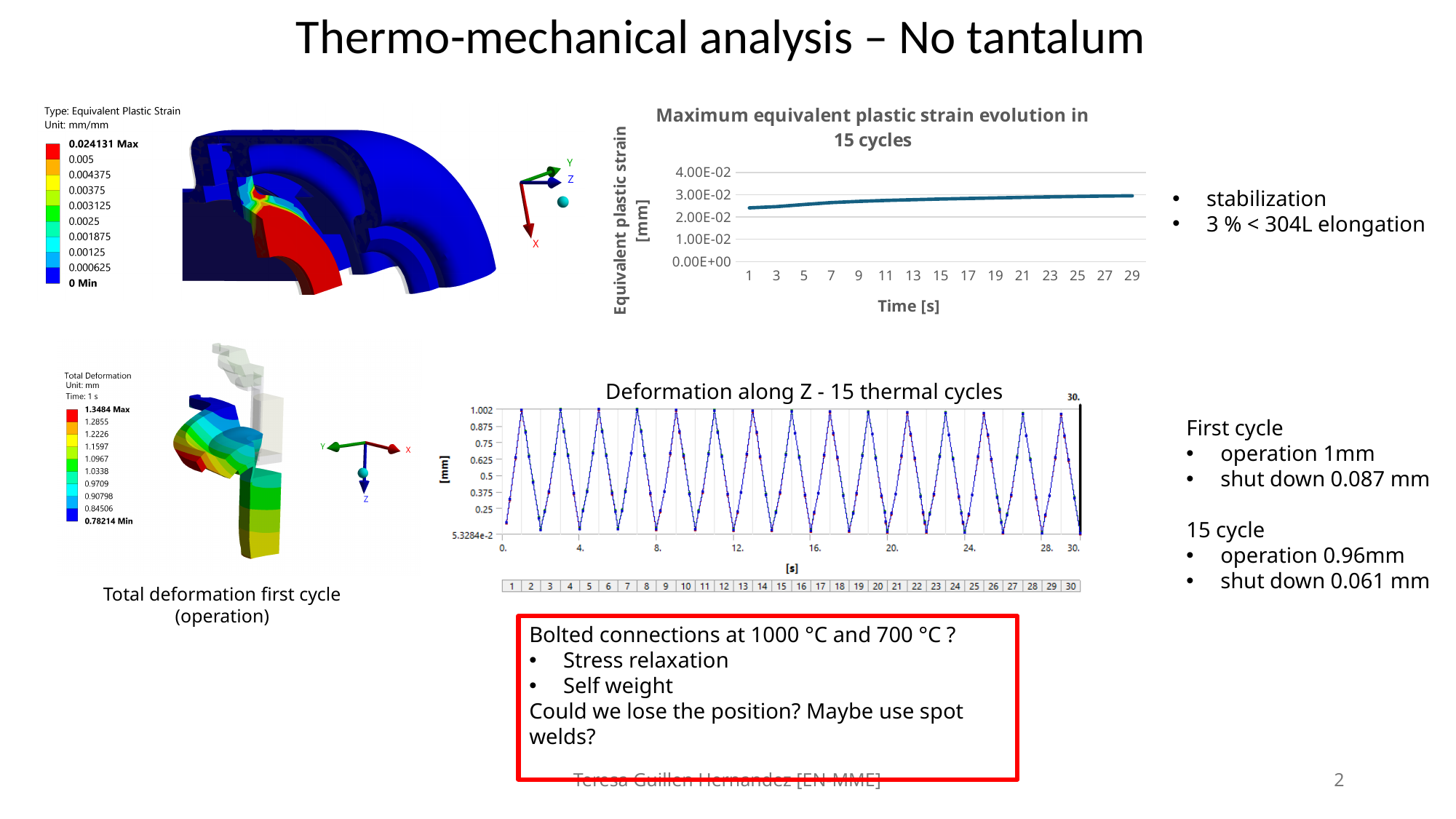
How many peaks (cycles) are plotted in the 'Deformation along Z - 15 thermal cycles' chart? 15 In the 'Deformation along Z - 15 thermal cycles' chart, what is the largest tick value shown on the x axis? 30. In the 'Deformation along Z - 15 thermal cycles' chart, is the value at the first peak greater or less than 0.875? greater In the 'Maximum equivalent plastic strain evolution in 15 cycles' chart, is the value at time 1 greater or less than 2.00E-02? greater What kind of chart is the 'Deformation along Z - 15 thermal cycles' chart? line chart In the 'Maximum equivalent plastic strain evolution in 15 cycles' chart, do the values rise or fall as time increases? rise In the 'Deformation along Z - 15 thermal cycles' chart, do the values steadily rise, steadily fall, or oscillate along the x axis? oscillate In the 'Maximum equivalent plastic strain evolution in 15 cycles' chart, is the value at time 29 greater or less than 4.00E-02? less What is the x-axis label of the 'Maximum equivalent plastic strain evolution in 15 cycles' chart? Time [s] In the 'Maximum equivalent plastic strain evolution in 15 cycles' chart, what is the highest tick value shown on the y axis? 4.00E-02 What kind of chart is the 'Maximum equivalent plastic strain evolution in 15 cycles' chart? line chart